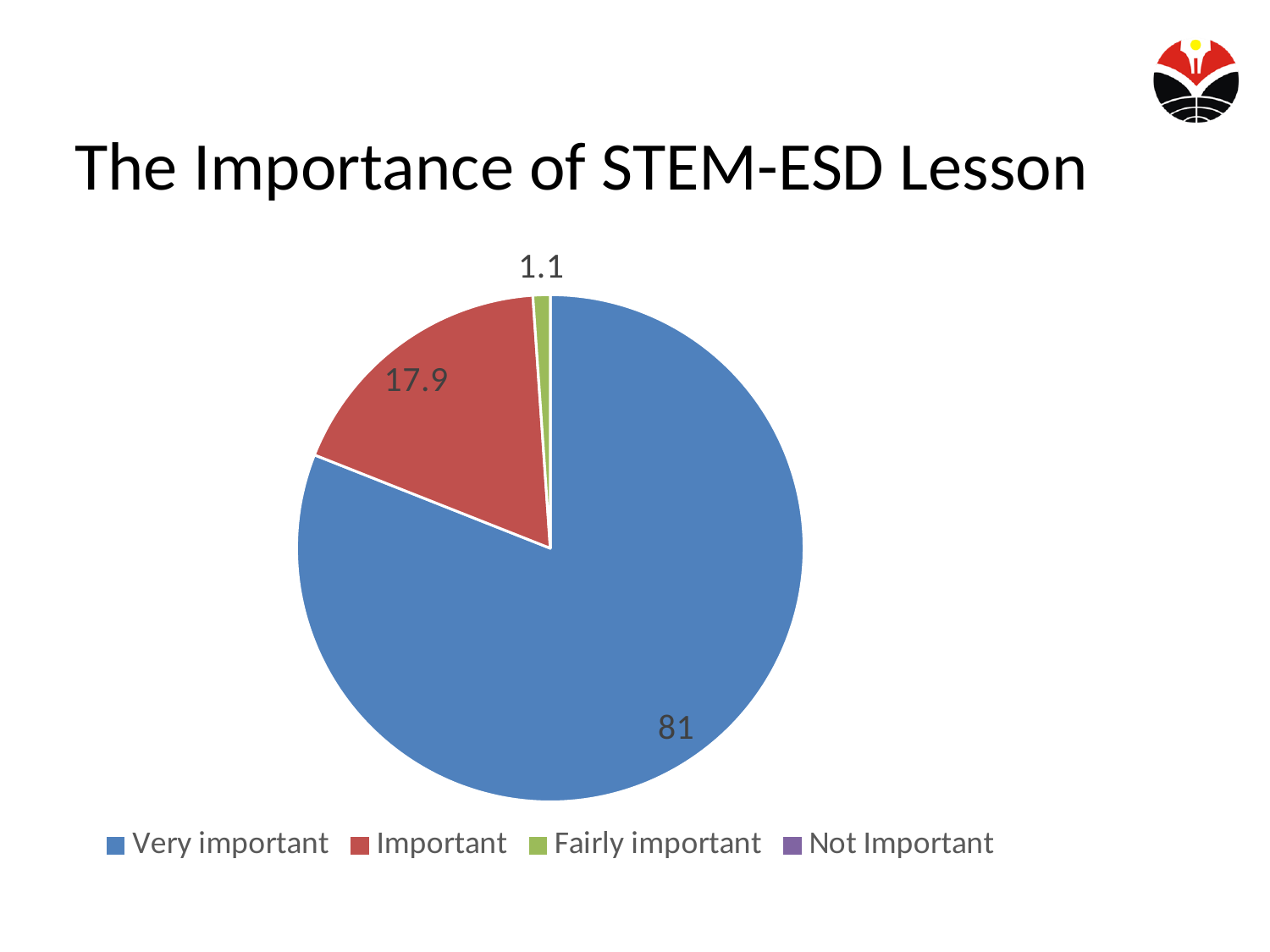
What is the value shown for the Very important slice? 81 What is the value shown for the Fairly important slice? 1.1 What is the difference between the Important value and the Fairly important value? 16.8 What is the title of the slide containing the chart? The Importance of STEM-ESD Lesson What colour represents the Important category in the legend? Red Which is larger, the Important slice or the Fairly important slice? Important What is the difference between the Very important value and the Important value? 63.1 Which category has the largest slice of the pie? Very important What is the value shown for the Important slice? 17.9 What kind of chart is shown on the slide? Pie chart Among the slices with data labels, which category has the smallest value? Fairly important How many categories does the legend list? 4